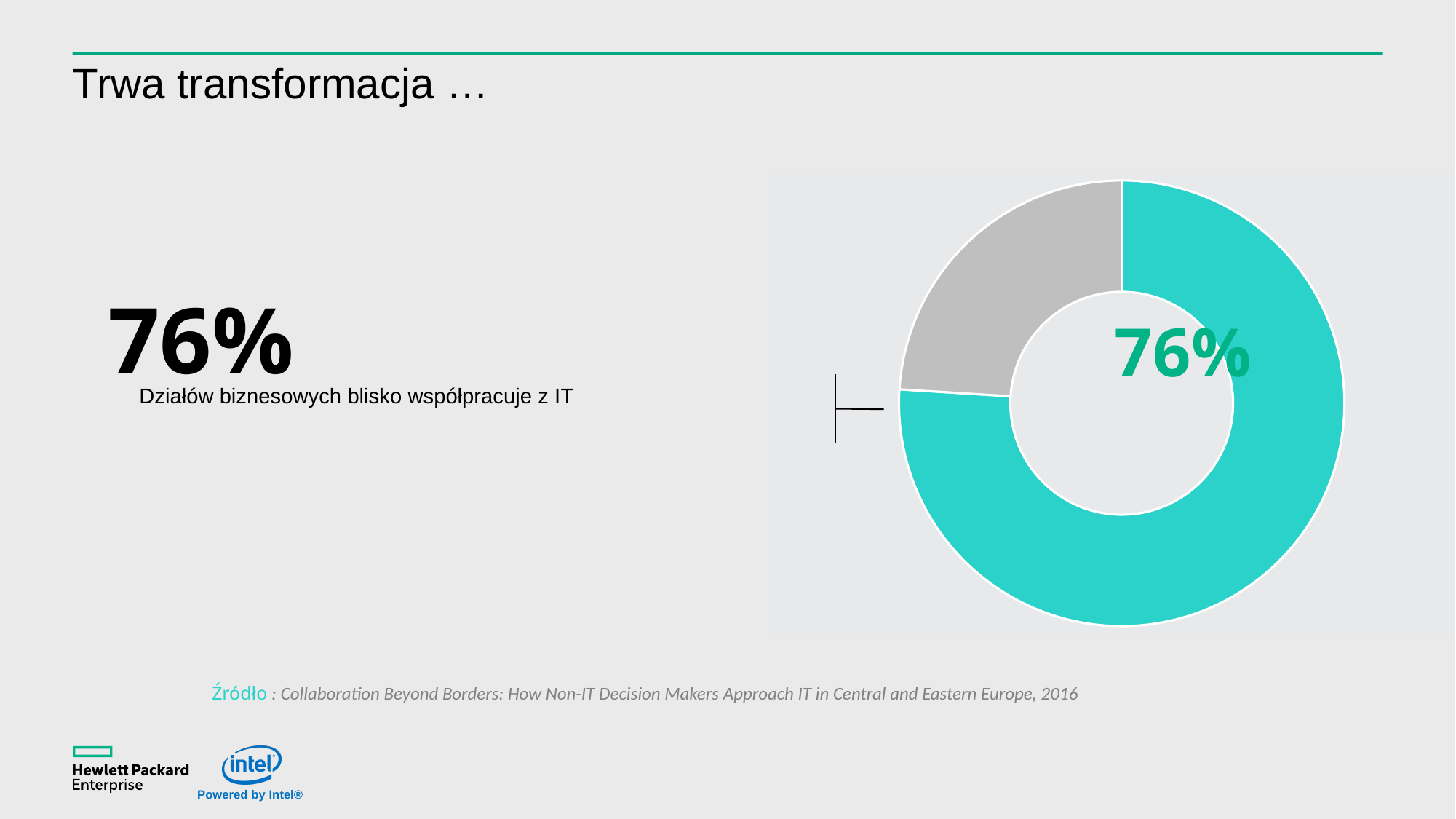
How many segments does the donut chart have? 2 What is the title of the slide containing the donut chart? Trwa transformacja … Which segment of the donut chart is larger, the teal one or the grey one? the teal one What share of the donut chart does the teal segment represent? 76% What kind of chart is shown on the slide? donut chart What colour is the largest segment of the donut chart? teal What value is printed on the donut chart? 76% What percentage of business departments closely cooperate with IT, according to the slide? 76%